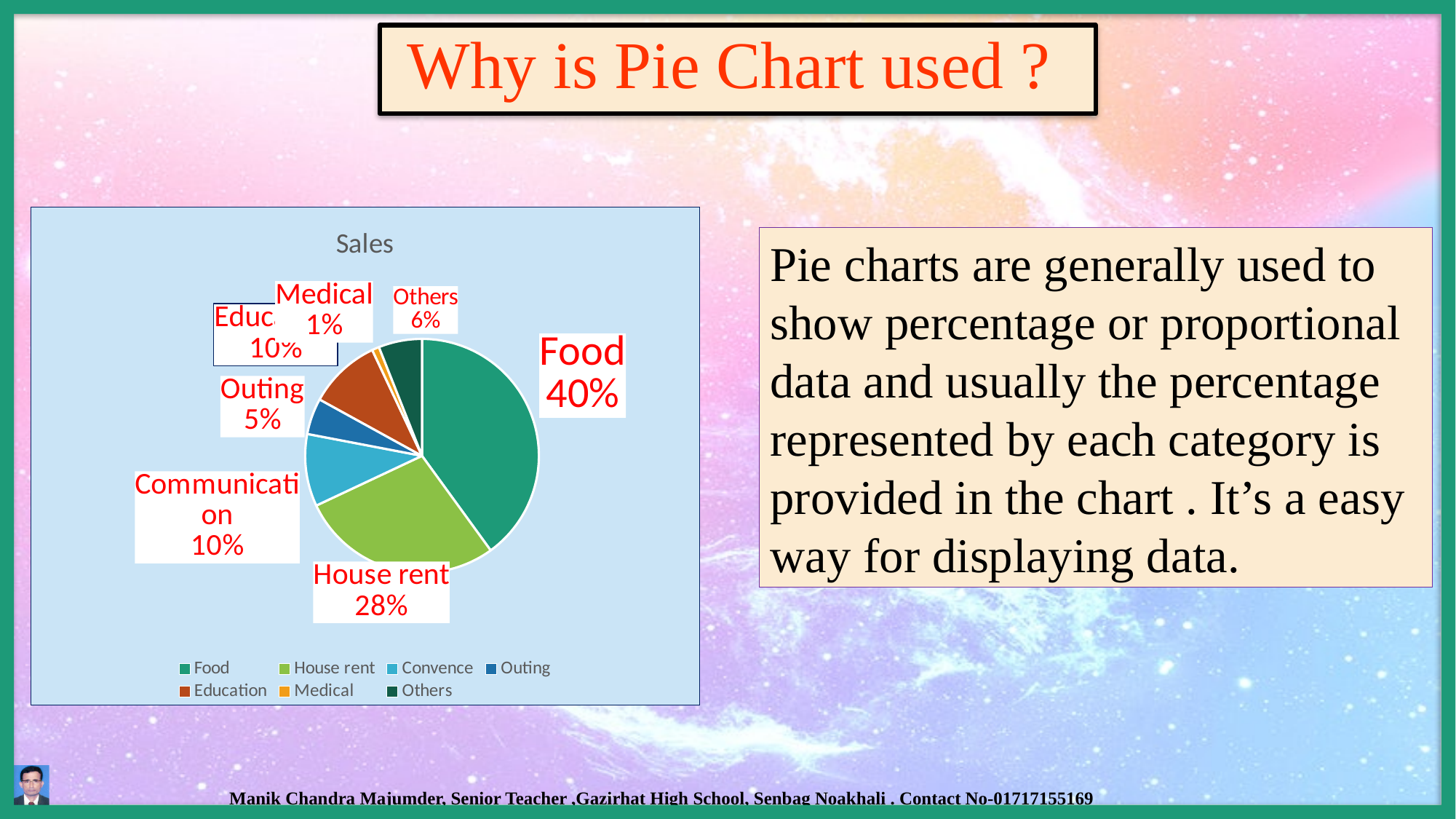
What percentage of the pie does Food represent? 40% How many categories are shown in the pie chart? 7 What is the value shown for Medical? 1% What is the title of the chart? Sales Which category has the smallest share of the pie? Medical What is the value shown for Others? 6% How many entries does the legend list? 7 How many percentage points larger is Food than House rent? 12 What is the value shown for House rent? 28% Which is larger, the share for Others or the share for Outing? Others Which category has the largest share of the pie? Food What type of chart is shown on the slide? Pie chart